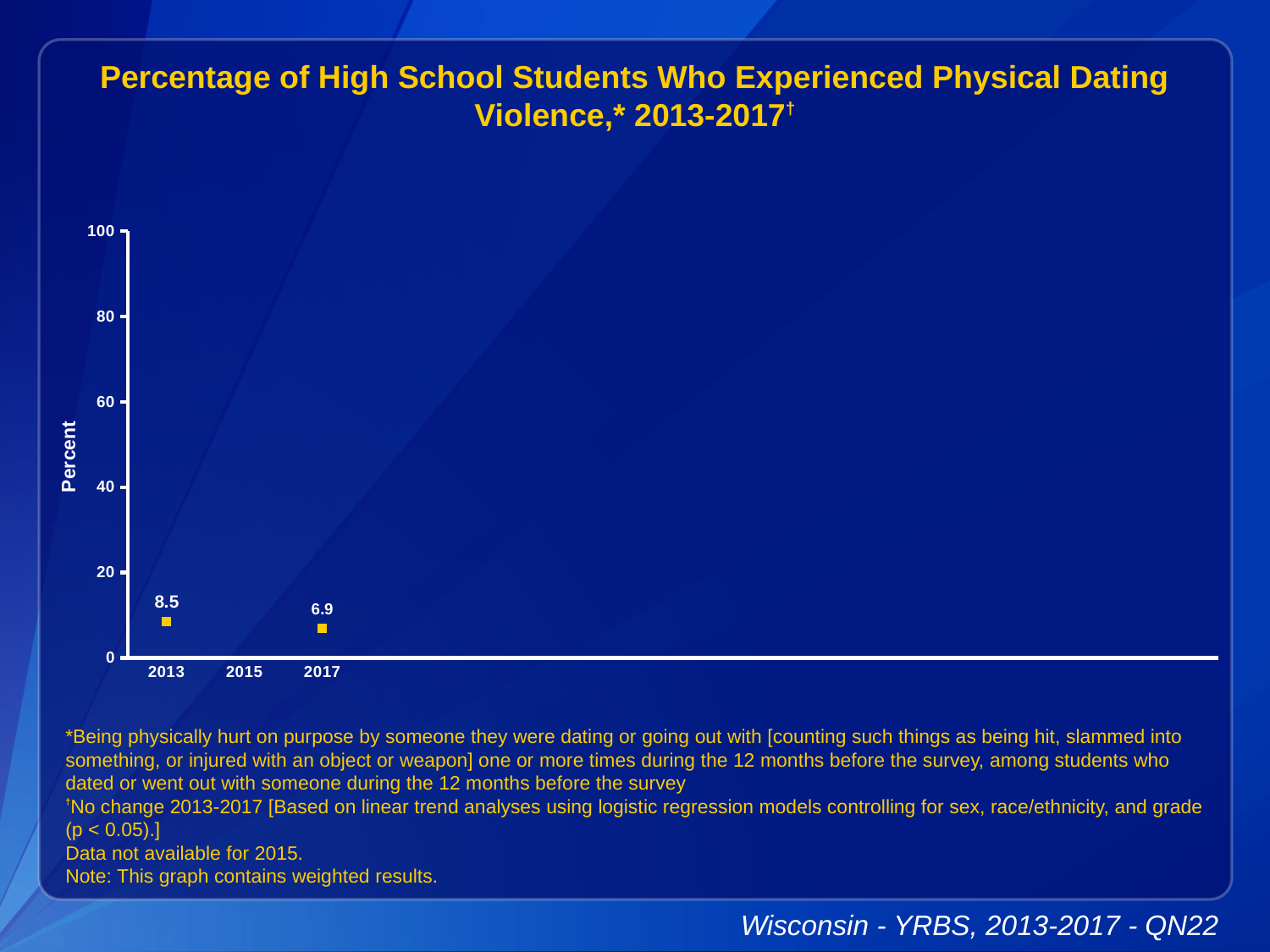
Is the value for 2013 greater or less than 20? less Which year shown has the lowest plotted percentage? 2017 How many years have data points plotted on the chart? 2 What is the maximum value shown on the y axis? 100 What is the difference between the 2013 and 2017 percentages? 1.6 Which year has the higher percentage, 2013 or 2017? 2013 What is the percentage of high school students who experienced physical dating violence in 2017? 6.9 Do the plotted values rise or fall from 2013 to 2017? fall For which year on the x axis is data not available? 2015 What is the label on the y axis? Percent What is the percentage of high school students who experienced physical dating violence in 2013? 8.5